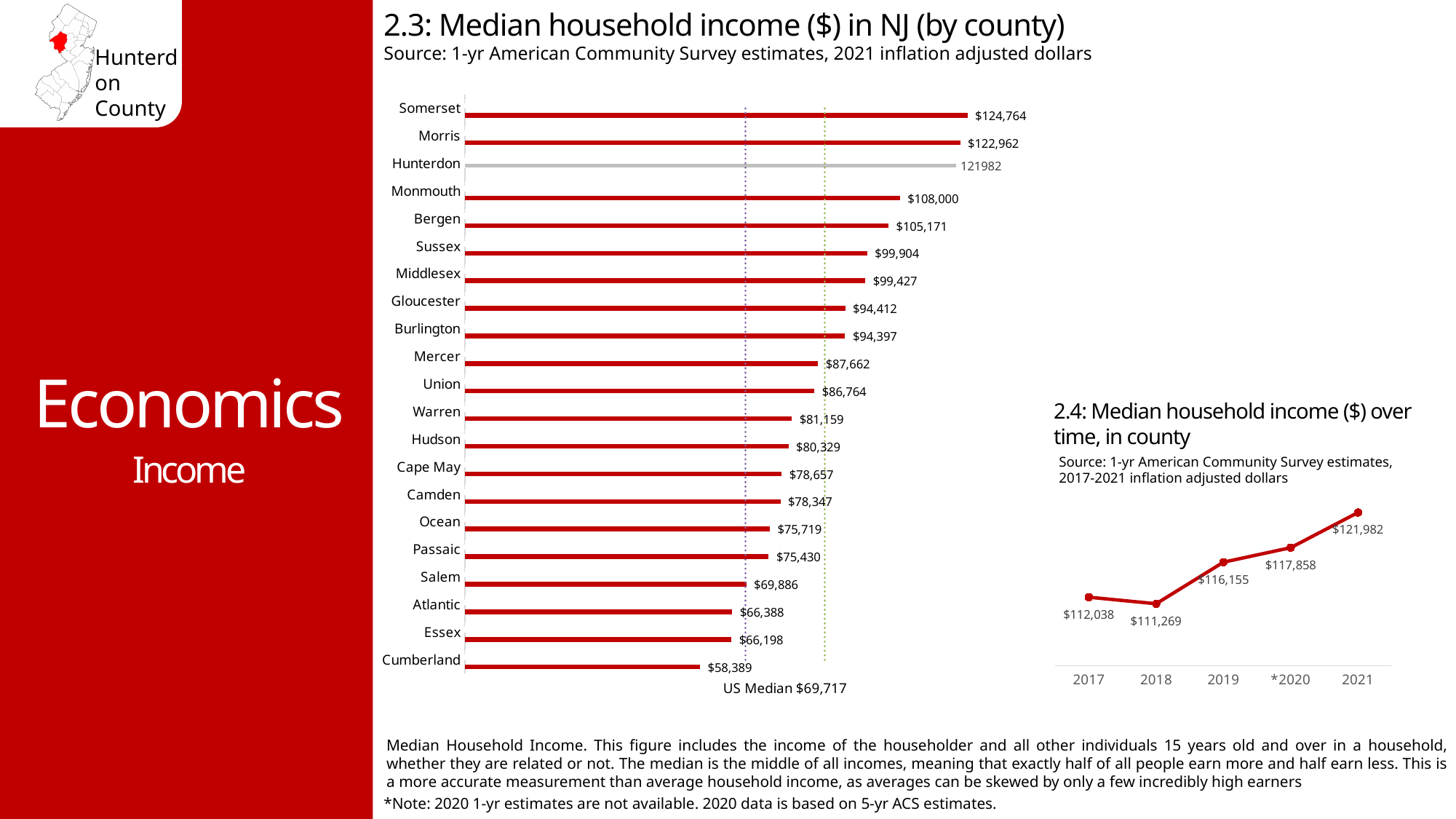
In chart 2.3 (Median household income in NJ by county), which county has the highest median household income? Somerset In chart 2.4 (Median household income over time, in county), what is the value for 2018? $111,269 In chart 2.3 (Median household income in NJ by county), which has a higher median household income, Monmouth or Mercer? Monmouth What kind of chart is chart 2.3 (Median household income in NJ by county)? Bar chart In chart 2.4 (Median household income over time, in county), what is the difference between the 2021 and 2017 values? $9,944 In chart 2.3 (Median household income in NJ by county), what is the difference between Somerset's and Cumberland's median household income? $66,375 In chart 2.3 (Median household income in NJ by county), how many counties are plotted? 21 In chart 2.3 (Median household income in NJ by county), what US Median value is noted below the chart? $69,717 In chart 2.4 (Median household income over time, in county), do the values generally rise or fall from 2018 to 2021? Rise In chart 2.3 (Median household income in NJ by county), which county has the lowest median household income? Cumberland In chart 2.3 (Median household income in NJ by county), what is the median household income for Hunterdon? 121982 In chart 2.3 (Median household income in NJ by county), what is the median household income for Somerset? $124,764